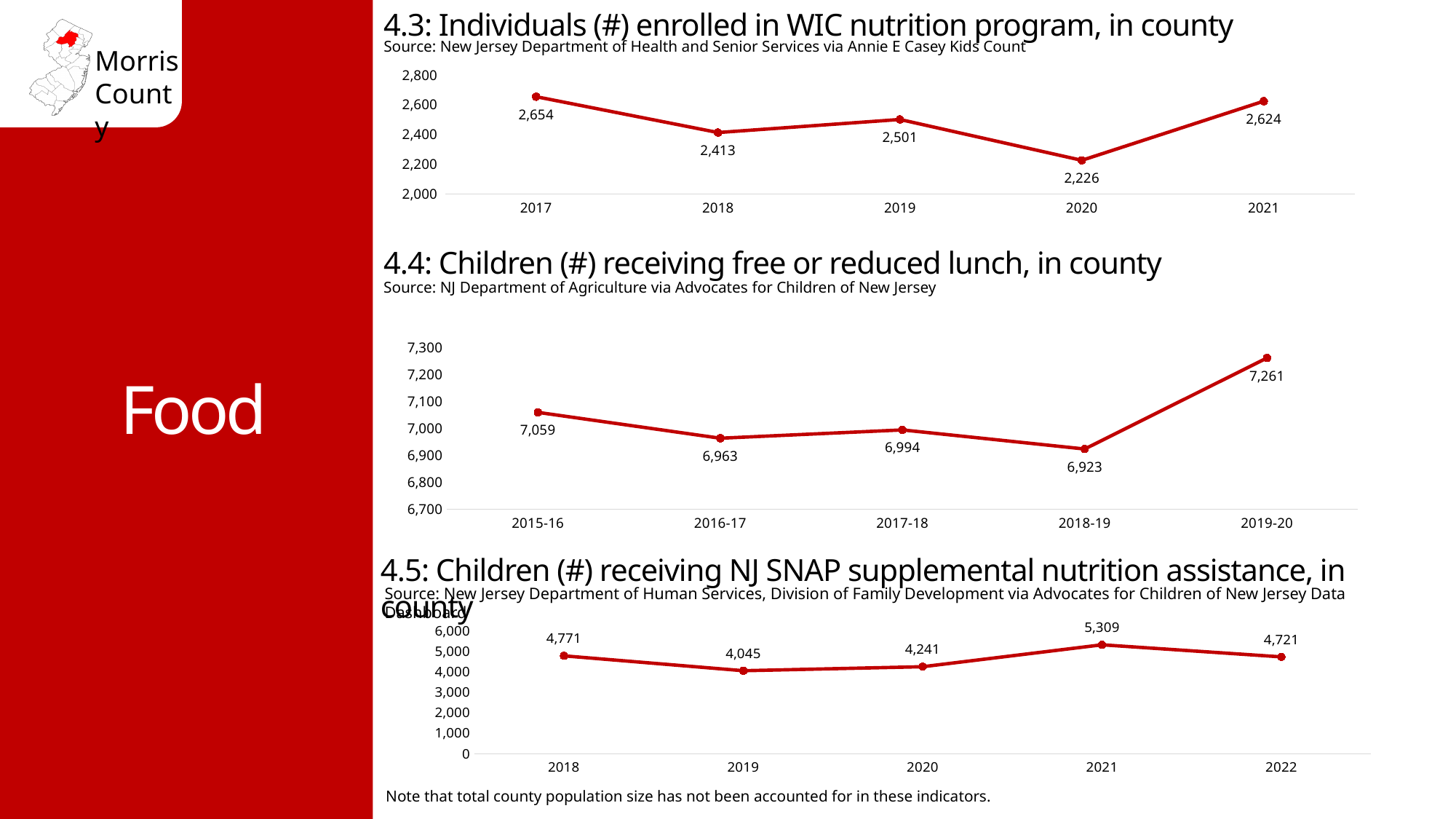
In the chart '4.4: Children (#) receiving free or reduced lunch, in county', which school year has the lowest value? 2018-19 In the chart '4.5: Children (#) receiving NJ SNAP supplemental nutrition assistance, in county', is the value for 2021 greater or less than 5,000? greater In the chart '4.3: Individuals (#) enrolled in WIC nutrition program, in county', which year has the highest value? 2017 In the chart '4.4: Children (#) receiving free or reduced lunch, in county', what is the difference between the 2019-20 and 2018-19 values? 338 In the chart '4.4: Children (#) receiving free or reduced lunch, in county', which is larger, the value for 2015-16 or the value for 2016-17? 2015-16 In the chart '4.5: Children (#) receiving NJ SNAP supplemental nutrition assistance, in county', what is the value for 2021? 5,309 In the chart '4.3: Individuals (#) enrolled in WIC nutrition program, in county', what is the value for 2020? 2,226 In the chart '4.4: Children (#) receiving free or reduced lunch, in county', what is the value for 2017-18? 6,994 What kind of chart is '4.5: Children (#) receiving NJ SNAP supplemental nutrition assistance, in county'? Line chart In the chart '4.3: Individuals (#) enrolled in WIC nutrition program, in county', what is the difference between the 2021 and 2020 values? 398 In the chart '4.5: Children (#) receiving NJ SNAP supplemental nutrition assistance, in county', which year has the lowest value? 2019 In the chart '4.3: Individuals (#) enrolled in WIC nutrition program, in county', how many years are plotted? 5